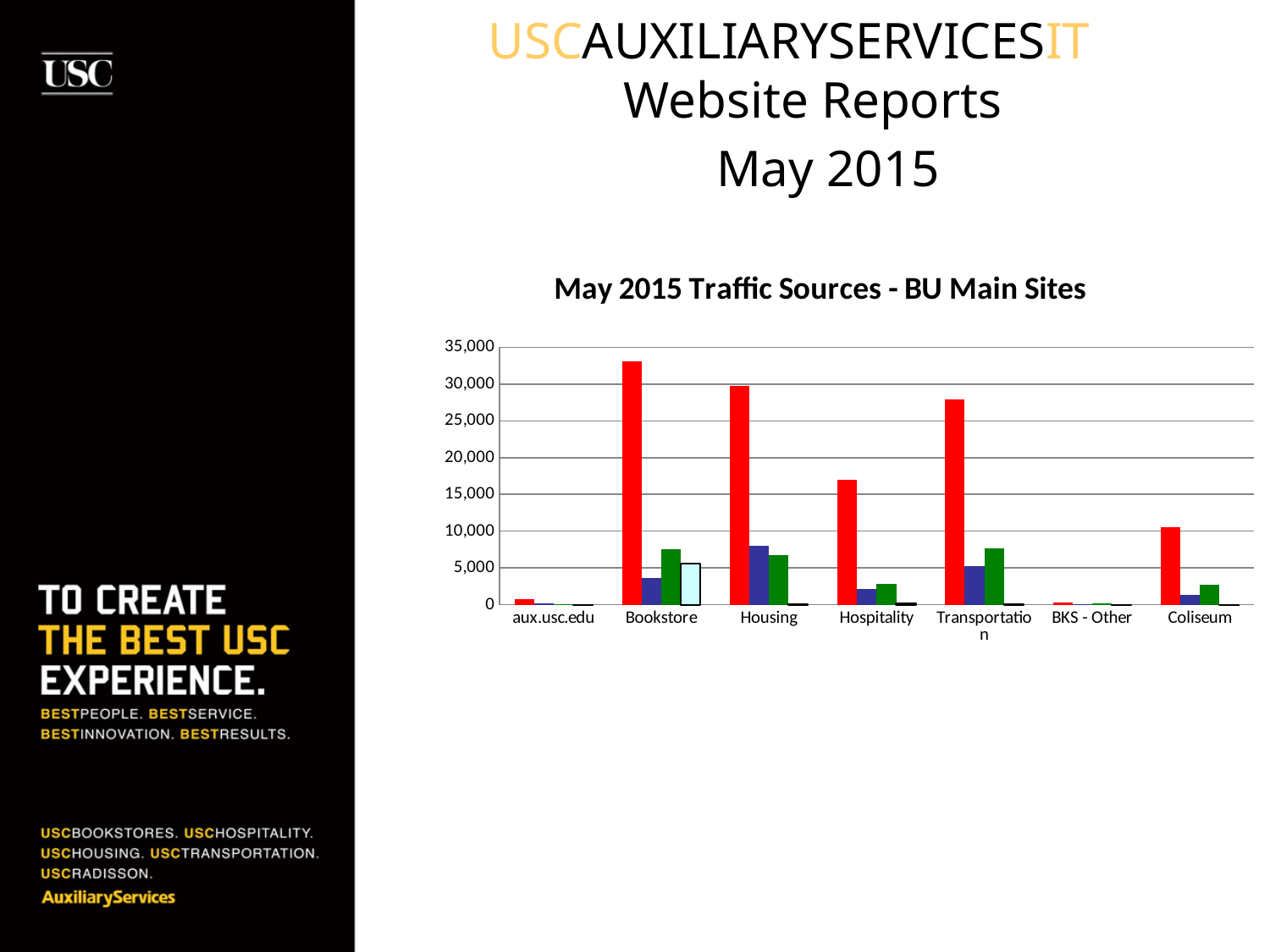
Is the red bar for Housing greater or less than 25,000? greater What type of chart is shown on the slide? bar chart Is the red bar for Bookstore greater or less than 30,000? greater How many categories are shown on the x axis of the chart? 7 Which has a taller red bar, Coliseum or Hospitality? Hospitality Is the red bar for Coliseum greater or less than 15,000? less What is the title of the chart? May 2015 Traffic Sources - BU Main Sites Which has a taller red bar, Bookstore or Hospitality? Bookstore Which category is the only one with a visible light blue bar? Bookstore Which category has the tallest red bar? Bookstore